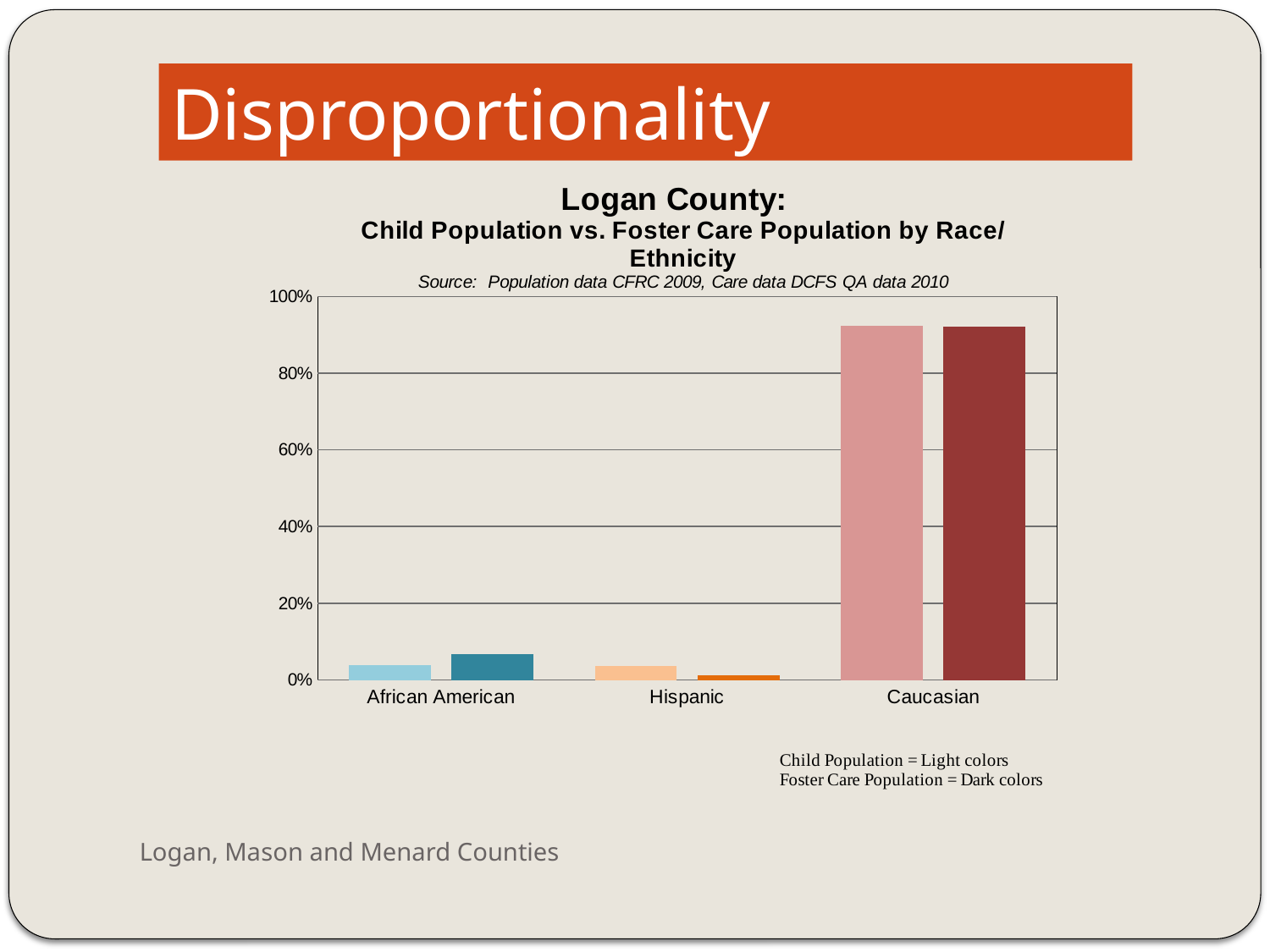
Which category has the highest child population share? Caucasian Is the African American foster care population value greater or less than 20%? less Is the Caucasian child population value greater or less than 80%? greater Is the Caucasian foster care population value greater or less than 80%? greater How many data series (populations) does the chart compare for each category? 2 For Hispanic, which is larger: the child population bar or the foster care population bar? child population Which category has the lowest foster care population share? Hispanic For African American, which is larger: the child population bar or the foster care population bar? foster care population Which category has the highest foster care population share? Caucasian How many race/ethnicity categories are shown on the x axis? 3 What kind of chart is shown on the slide? bar chart According to the note below the chart, which population is shown in dark colors? Foster Care Population